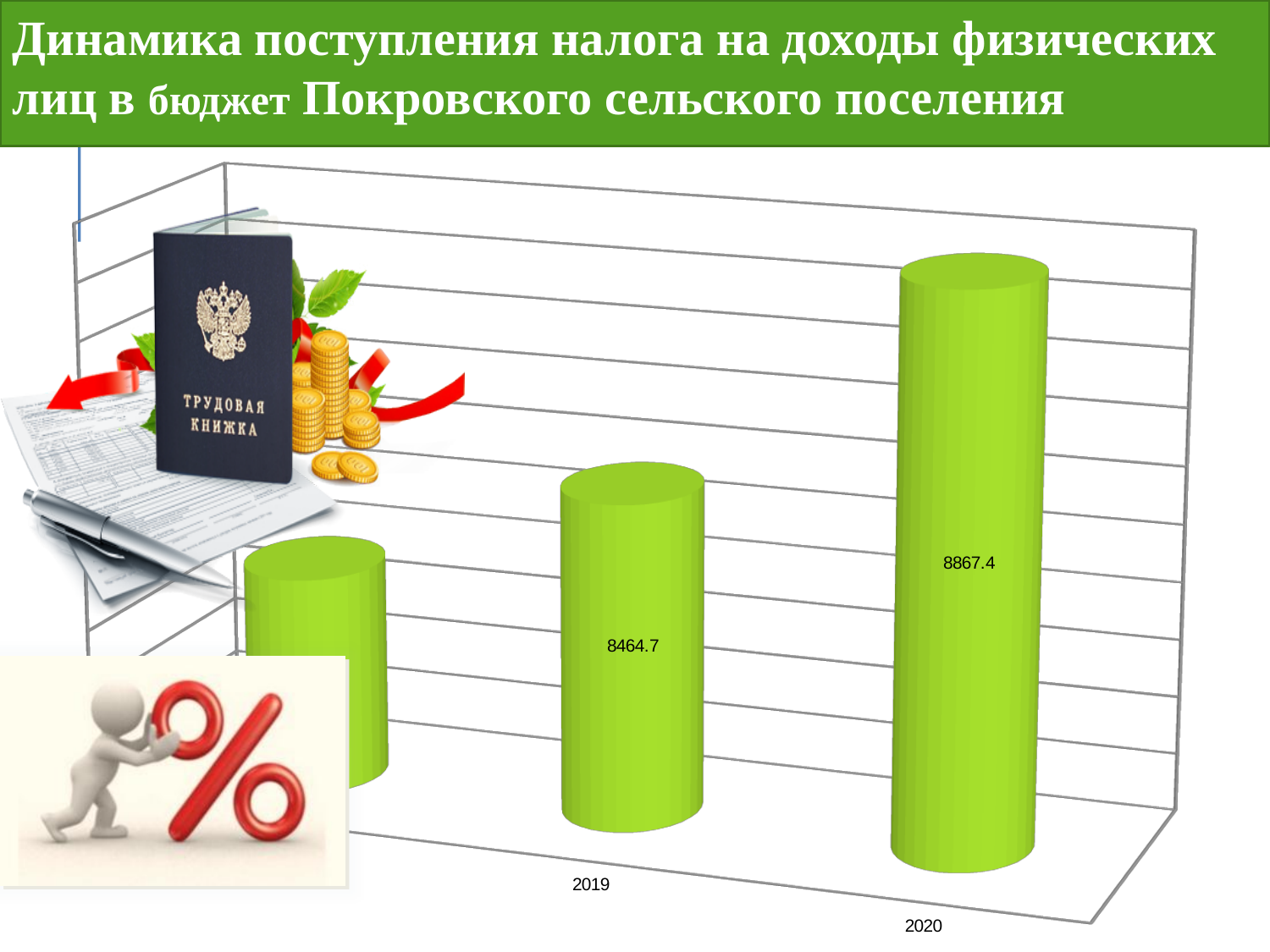
What is the value for 2019? 8464.7 How many bars are plotted on the chart? 3 What is the difference between the values for 2020 and 2019? 402.7 What is the value for 2020? 8867.4 What colour are the bars on the chart? green Do the values rise or fall from left to right along the x axis? rise Which is larger, the value for 2019 or the value for 2020? 2020 What kind of chart is shown on the slide? bar chart What is the title of the slide? Динамика поступления налога на доходы физических лиц в бюджет Покровского сельского поселения Which year has the highest value on the chart? 2020